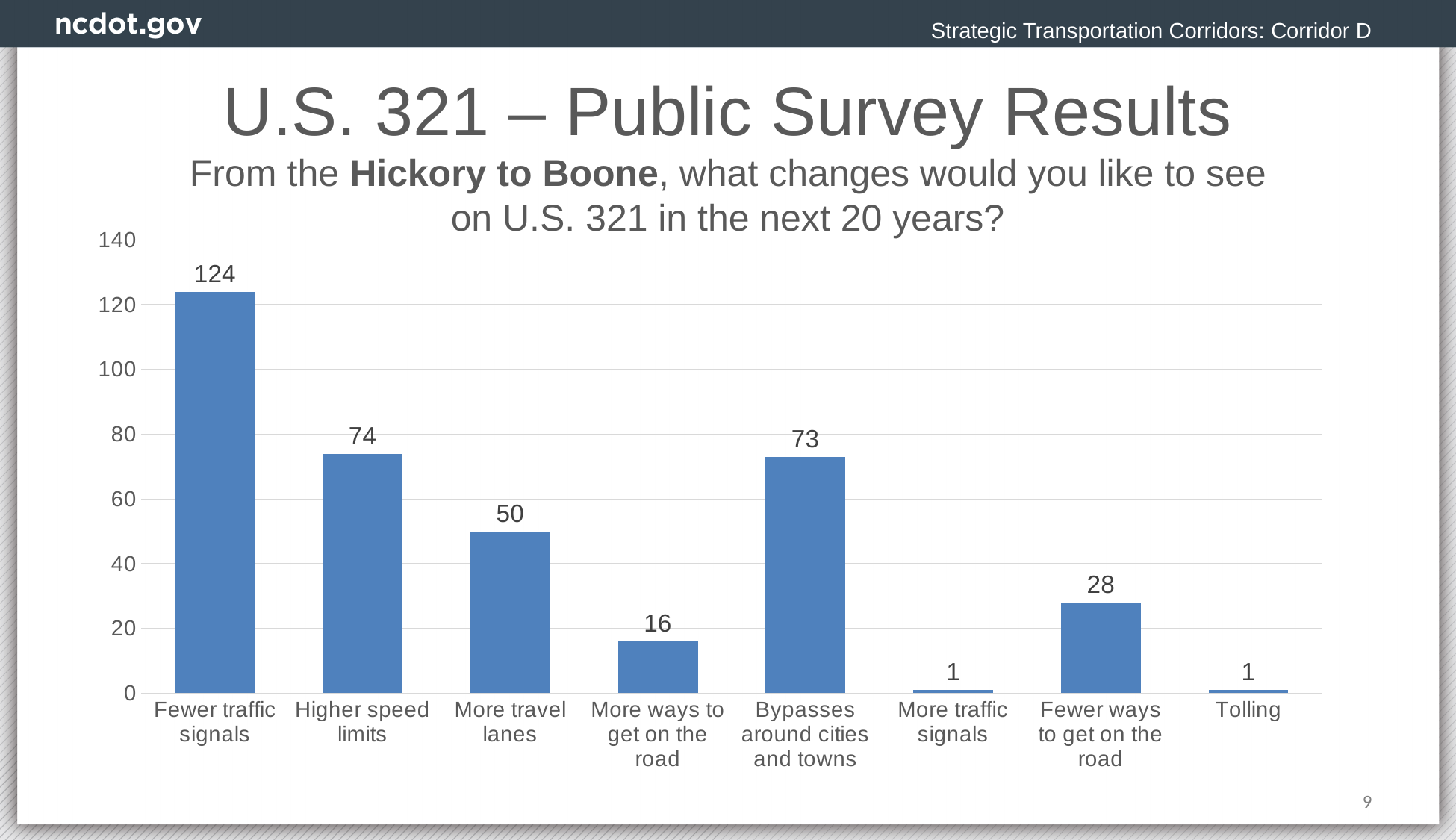
What kind of chart is shown on the slide? bar chart What is the difference between the values for "Fewer traffic signals" and "Higher speed limits"? 50 What is the value for "Bypasses around cities and towns"? 73 How many categories are shown on the x axis of the chart? 8 Is the value for "Higher speed limits" greater or less than 60? greater Which is larger, the value for "More travel lanes" or the value for "Fewer ways to get on the road"? More travel lanes What is the difference between the values for "More travel lanes" and "Fewer ways to get on the road"? 22 What is the value for "More ways to get on the road"? 16 What is the value for "Fewer traffic signals"? 124 What question is the chart's subtitle asking survey respondents? From the Hickory to Boone, what changes would you like to see on U.S. 321 in the next 20 years? Which category has the highest value? Fewer traffic signals What is the value for "Tolling"? 1